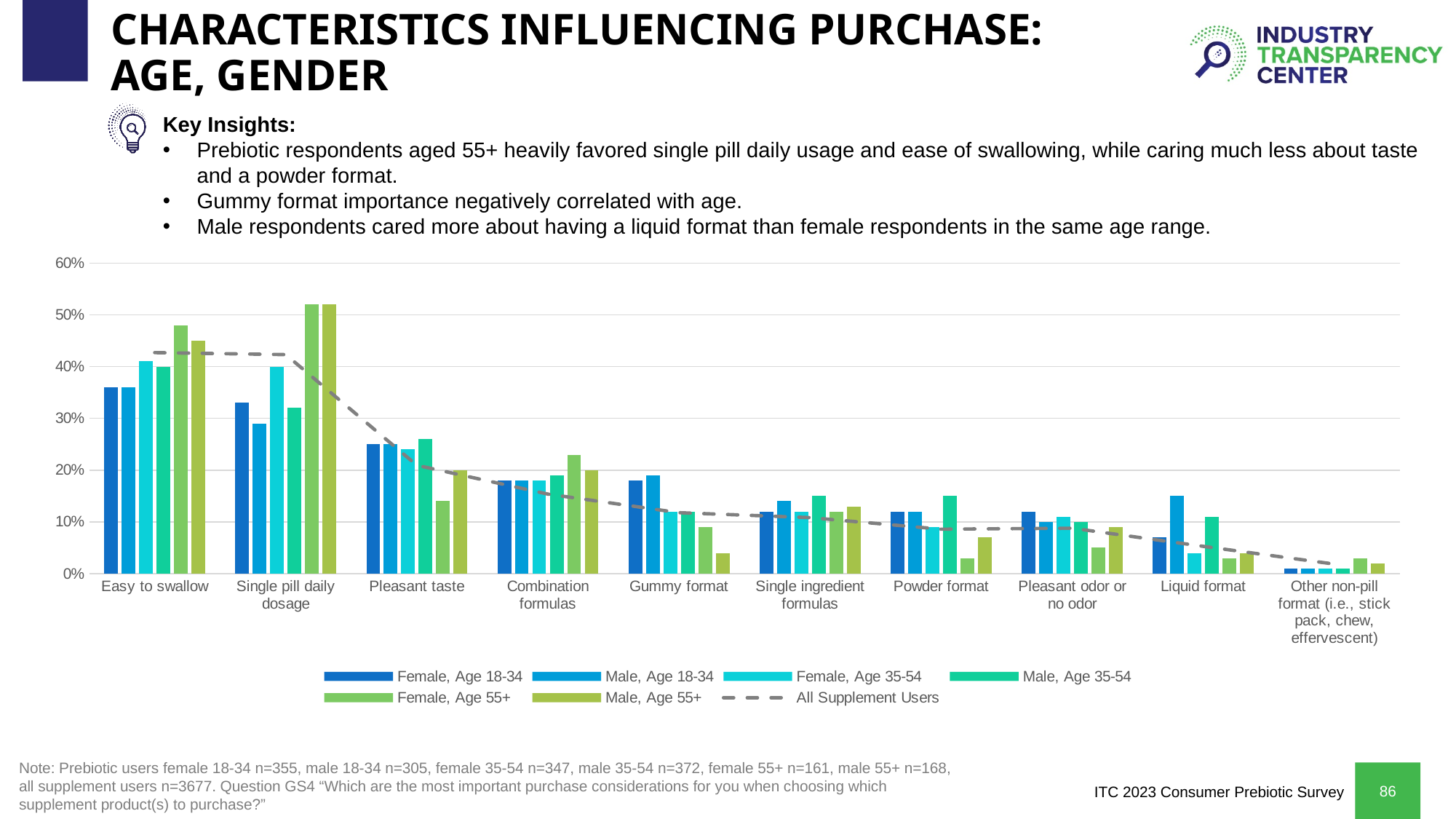
Is the value for Male, Age 55+ on Gummy format greater or less than 10%? less Is the value for Male, Age 18-34 on Liquid format greater or less than 10%? greater How many series does the legend list? 7 Which series has the highest value for Easy to swallow? Female, Age 55+ Which series has the lowest value for Gummy format? Male, Age 55+ How many purchase characteristics (categories) are shown along the x axis? 10 Is the value for Male, Age 55+ on Single pill daily dosage greater or less than 50%? greater What kind of chart is shown on the slide? Combination bar and line chart What does the dashed grey line in the chart represent? All Supplement Users Does the dashed All Supplement Users line rise or fall from left to right across the categories? Fall For Liquid format, which is larger: Male, Age 18-34 or Female, Age 18-34? Male, Age 18-34